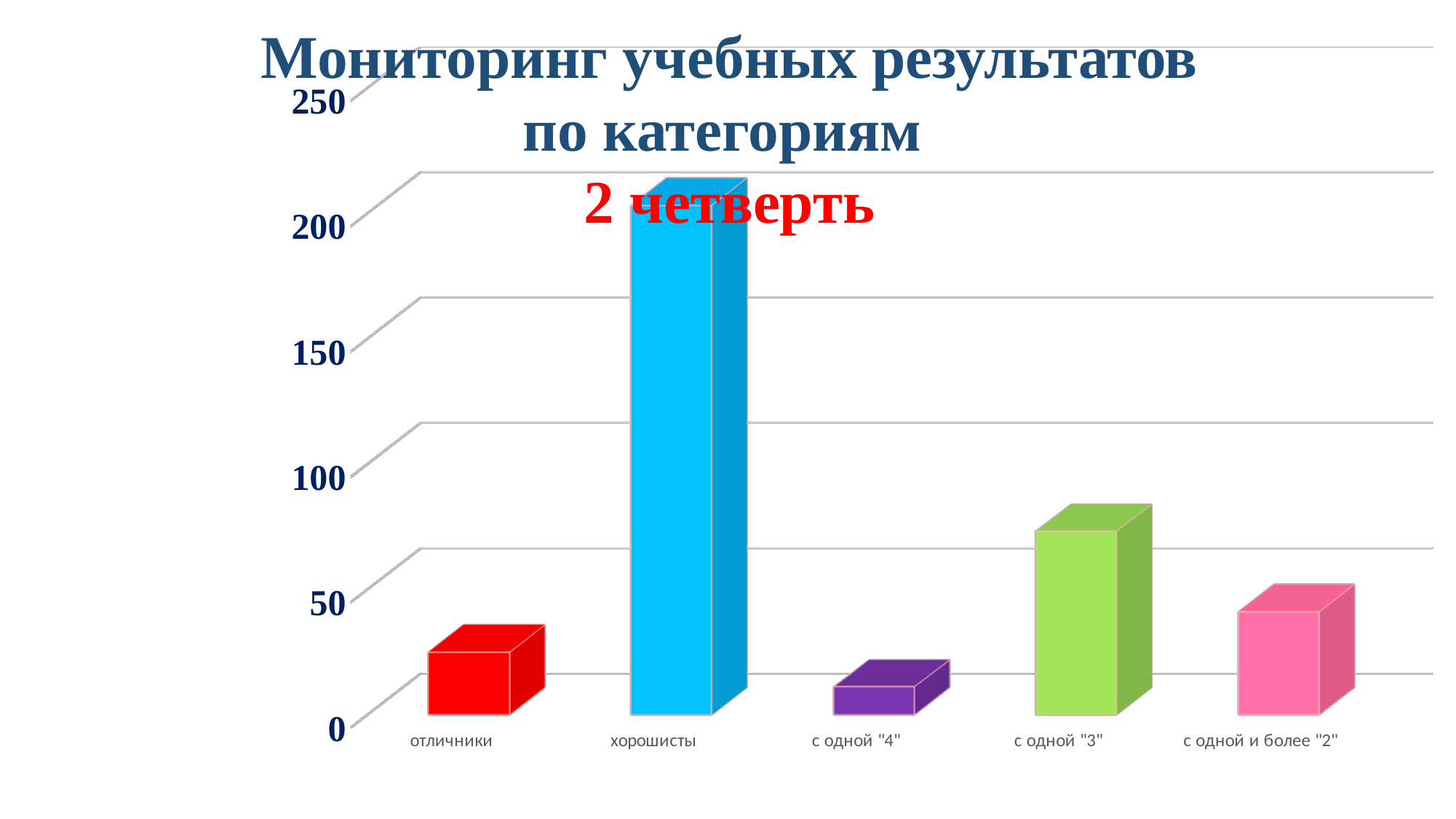
Is the value for отличники greater or less than 50? less Is the value for с одной и более "2" greater or less than 100? less Is the value for с одной "3" greater or less than 50? greater Which is larger, the value for хорошисты or the value for с одной и более "2"? хорошисты Which is larger, the value for с одной "3" or the value for отличники? с одной "3" Which category has the highest bar? хорошисты Which category has the lowest bar? с одной "4" What kind of chart is shown on the slide? bar chart How many categories are shown on the x axis of the chart? 5 What is the title of the chart? Мониторинг учебных результатов по категориям